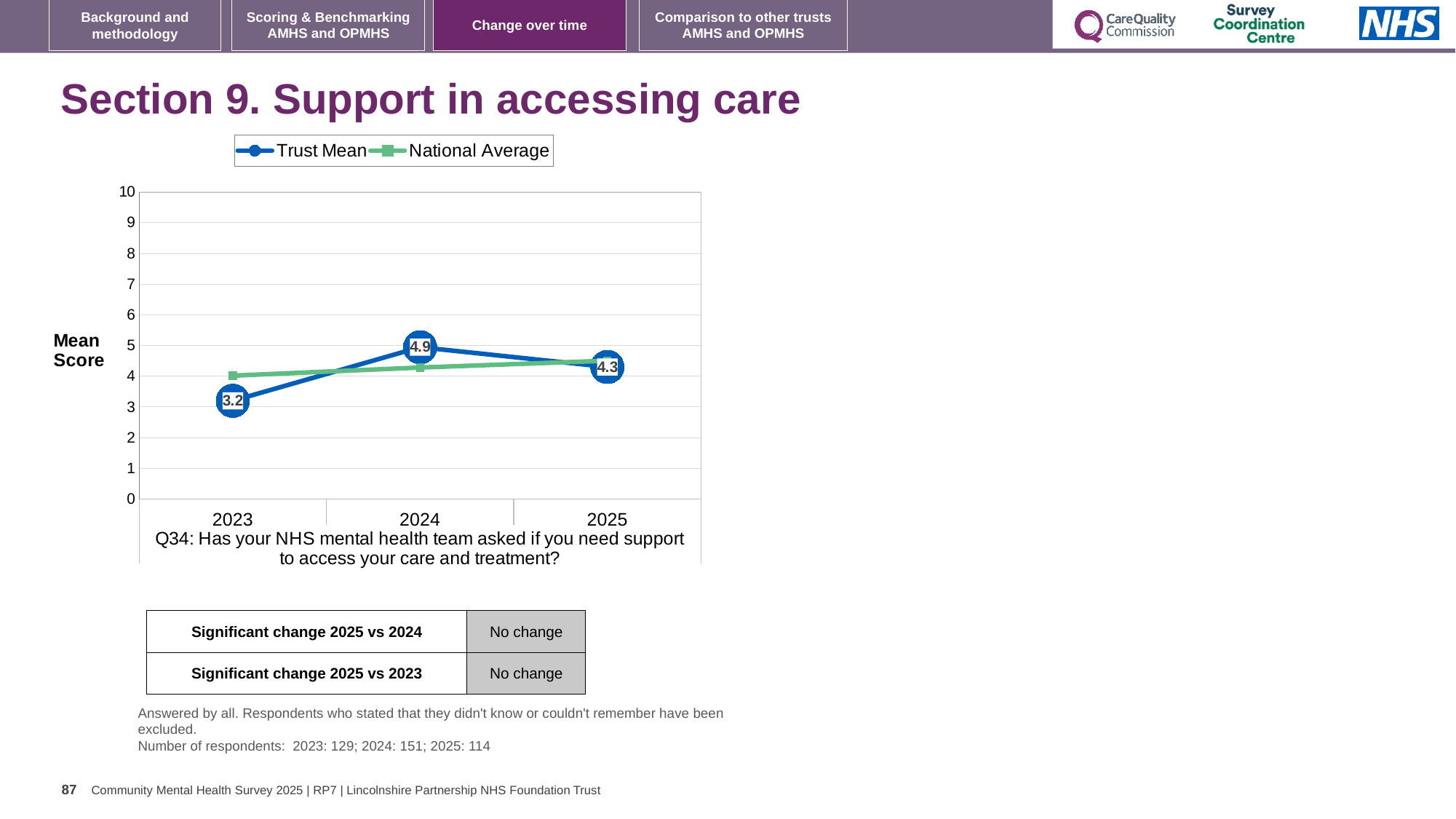
How many series does the legend list? 2 What kind of chart is shown on the slide? line chart What is the Trust Mean score for 2024? 4.9 In 2023, which is larger: the Trust Mean or the National Average? National Average What is the Trust Mean score for 2023? 3.2 Is the National Average value for 2023 greater or less than 5? less What is the Trust Mean score for 2025? 4.3 What is the difference between the Trust Mean in 2024 and in 2025? 0.6 How many years are plotted on the x axis? 3 In which year is the Trust Mean lowest? 2023 By how much did the Trust Mean change from 2023 to 2024? 1.7 In which year is the Trust Mean highest? 2024